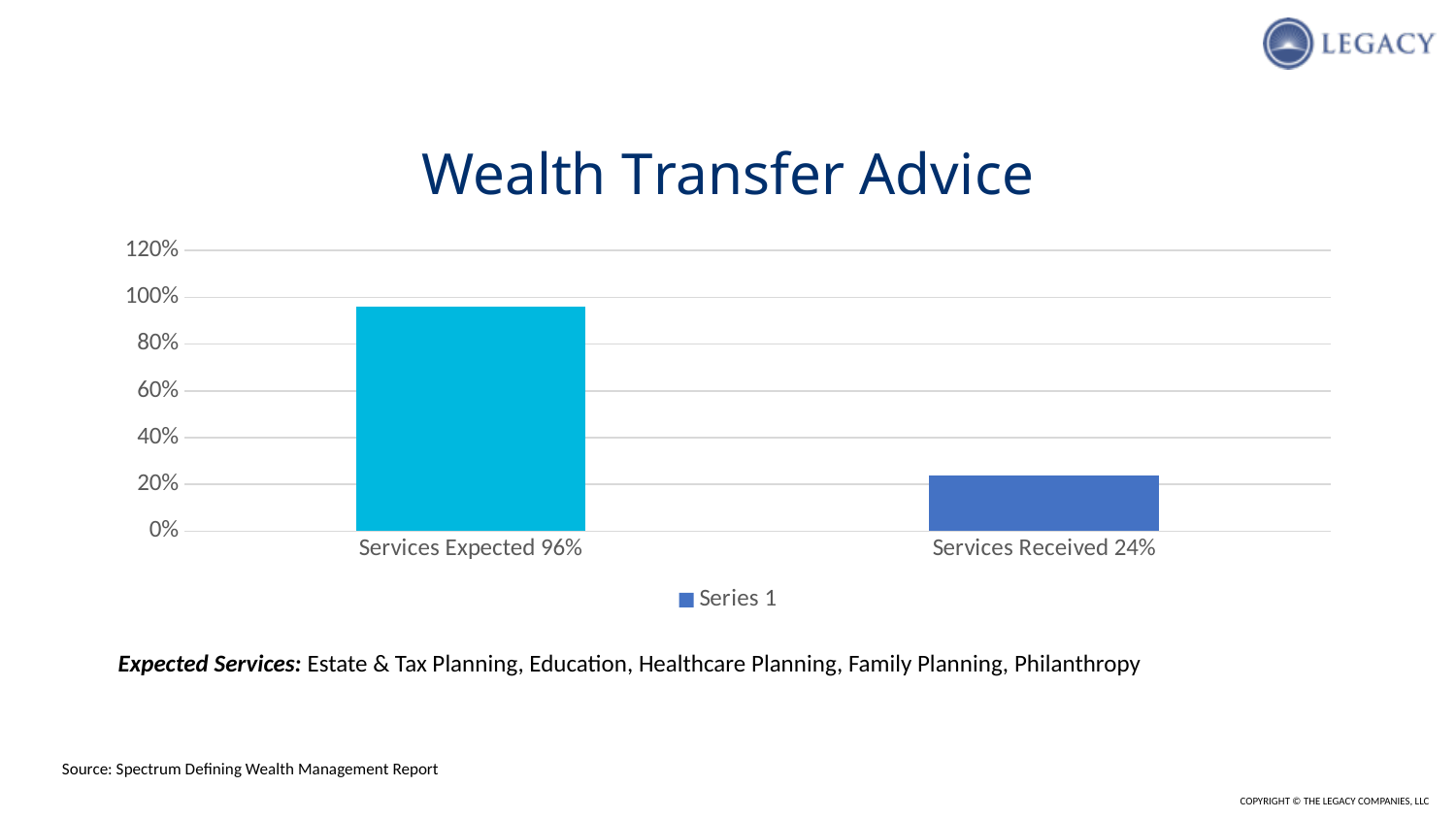
Which category has the highest value? Services Expected What is the value for Services Received? 24% How many categories are shown in the chart? 2 Which category has the lowest value? Services Received What is the difference between Services Expected and Services Received? 72% How many series does the legend list? 1 Which is larger, Services Expected or Services Received? Services Expected Is the value for Services Expected greater or less than 80%? greater Is the value for Services Received greater or less than 40%? less What is the title of the chart? Wealth Transfer Advice What is the value for Services Expected? 96% What kind of chart is shown on the slide? Bar chart